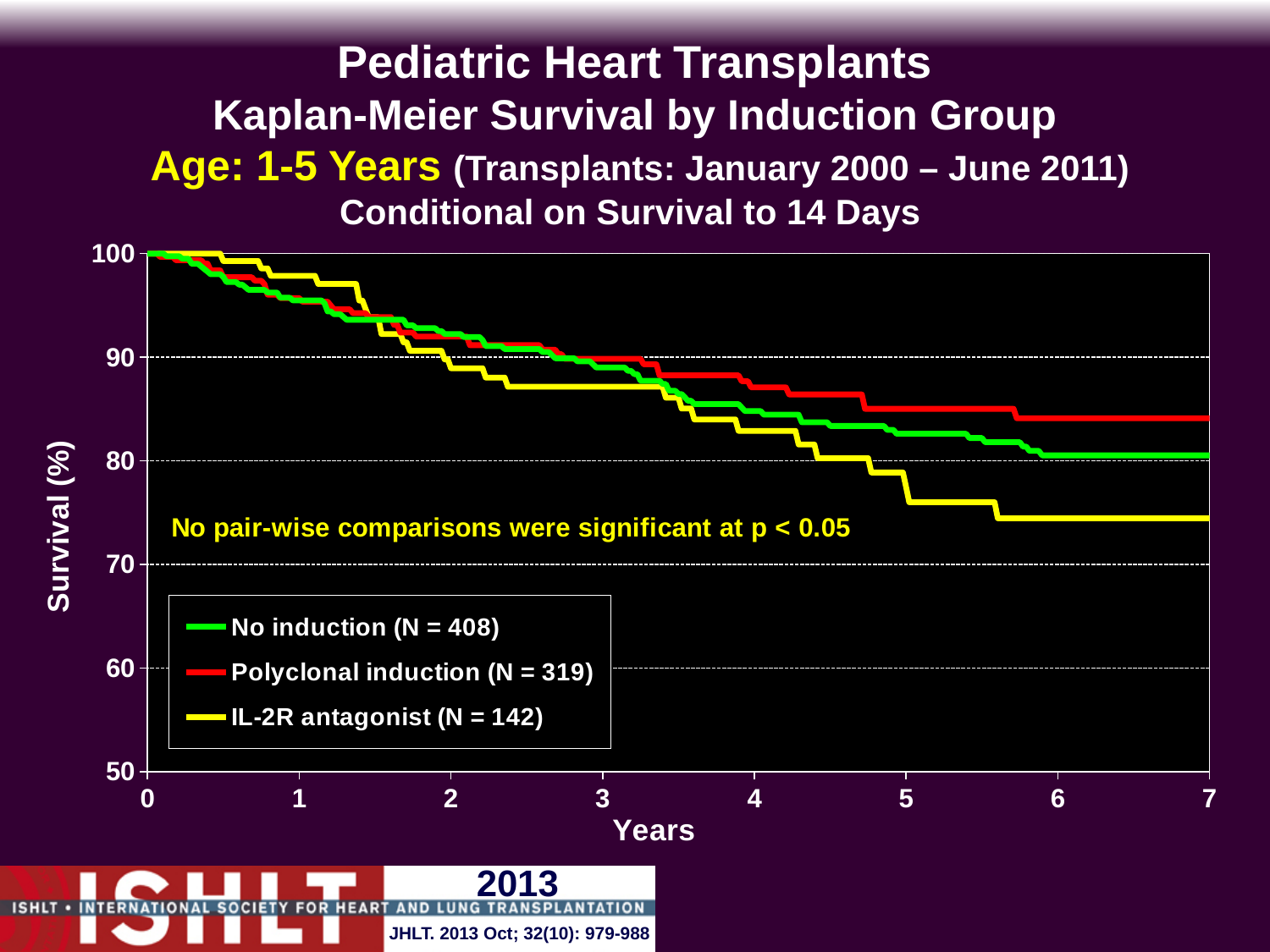
At 7 years, is survival higher for Polyclonal induction or IL-2R antagonist? Polyclonal induction Do the survival curves rise or fall as years increase? Fall Is the survival for IL-2R antagonist at 7 years greater or less than 80? less What kind of chart is shown on the slide? Line chart (Kaplan-Meier survival curve) What is the N for the No induction group shown in the legend? 408 Which induction group has the highest survival at 7 years? Polyclonal induction How many series does the legend list? 3 What is the survival (%) for all groups at year 0? 100 Is the survival for Polyclonal induction at 7 years greater or less than 80? greater Which induction group has the lowest survival at 7 years? IL-2R antagonist Is the survival for No induction at 2 years greater or less than 90? greater